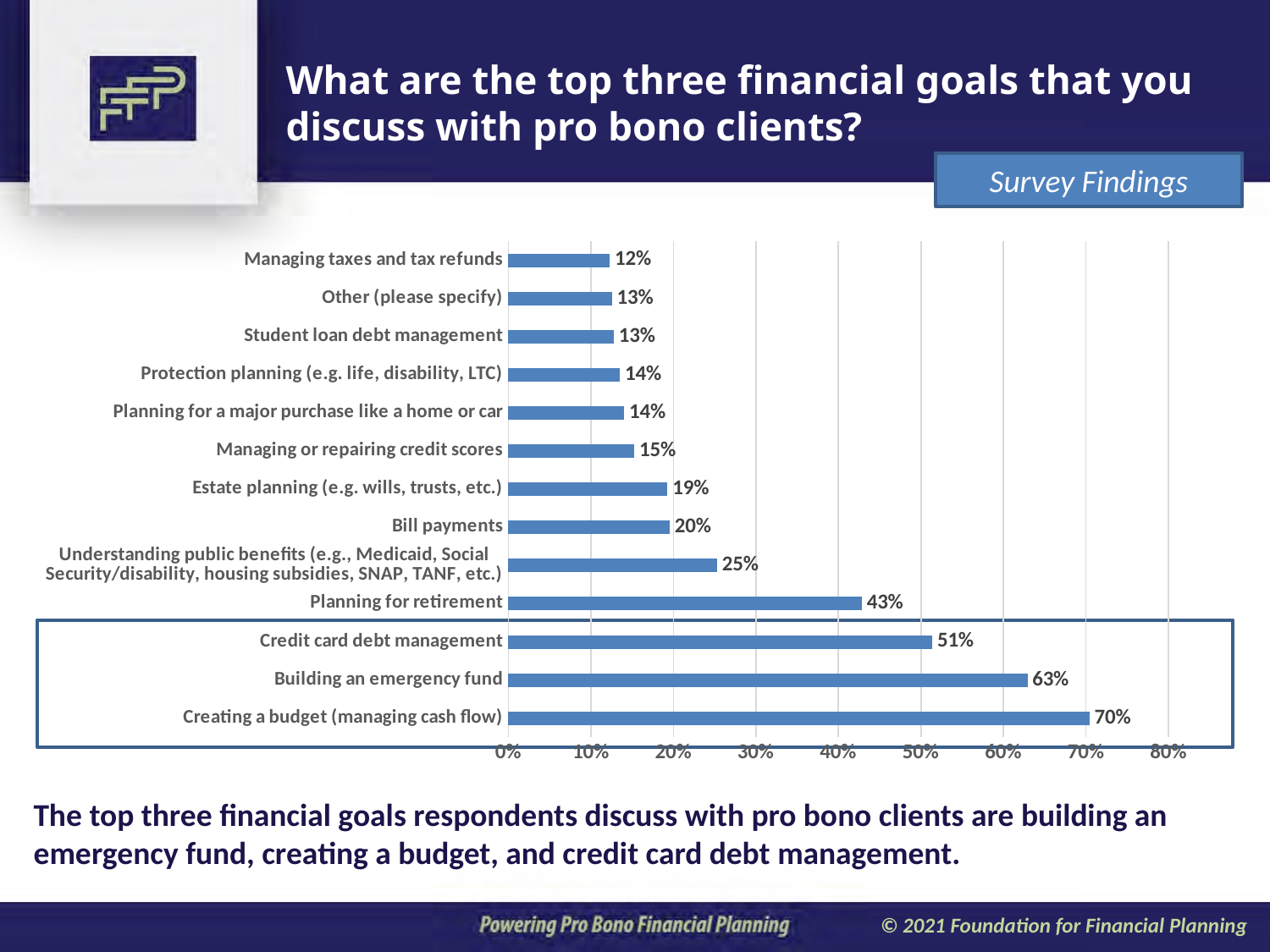
What type of chart is shown on the slide? Bar chart Is the value for Planning for retirement greater or less than 40%? greater What percentage of respondents discuss creating a budget (managing cash flow) with pro bono clients? 70% Which financial goal has the highest percentage on the chart? Creating a budget (managing cash flow) Which has a higher percentage: Bill payments or Estate planning (e.g. wills, trusts, etc.)? Bill payments What is the value shown for Planning for retirement? 43% What is the difference between the percentages for Building an emergency fund and Credit card debt management? 12% What is the difference between the percentages for Creating a budget (managing cash flow) and Planning for retirement? 27% How many financial goal categories are shown on the chart? 13 What is the maximum value shown on the chart's horizontal axis? 80% Which financial goal has the lowest percentage on the chart? Managing taxes and tax refunds What is the value shown for Understanding public benefits (e.g., Medicaid, Social Security/disability, housing subsidies, SNAP, TANF, etc.)? 25%